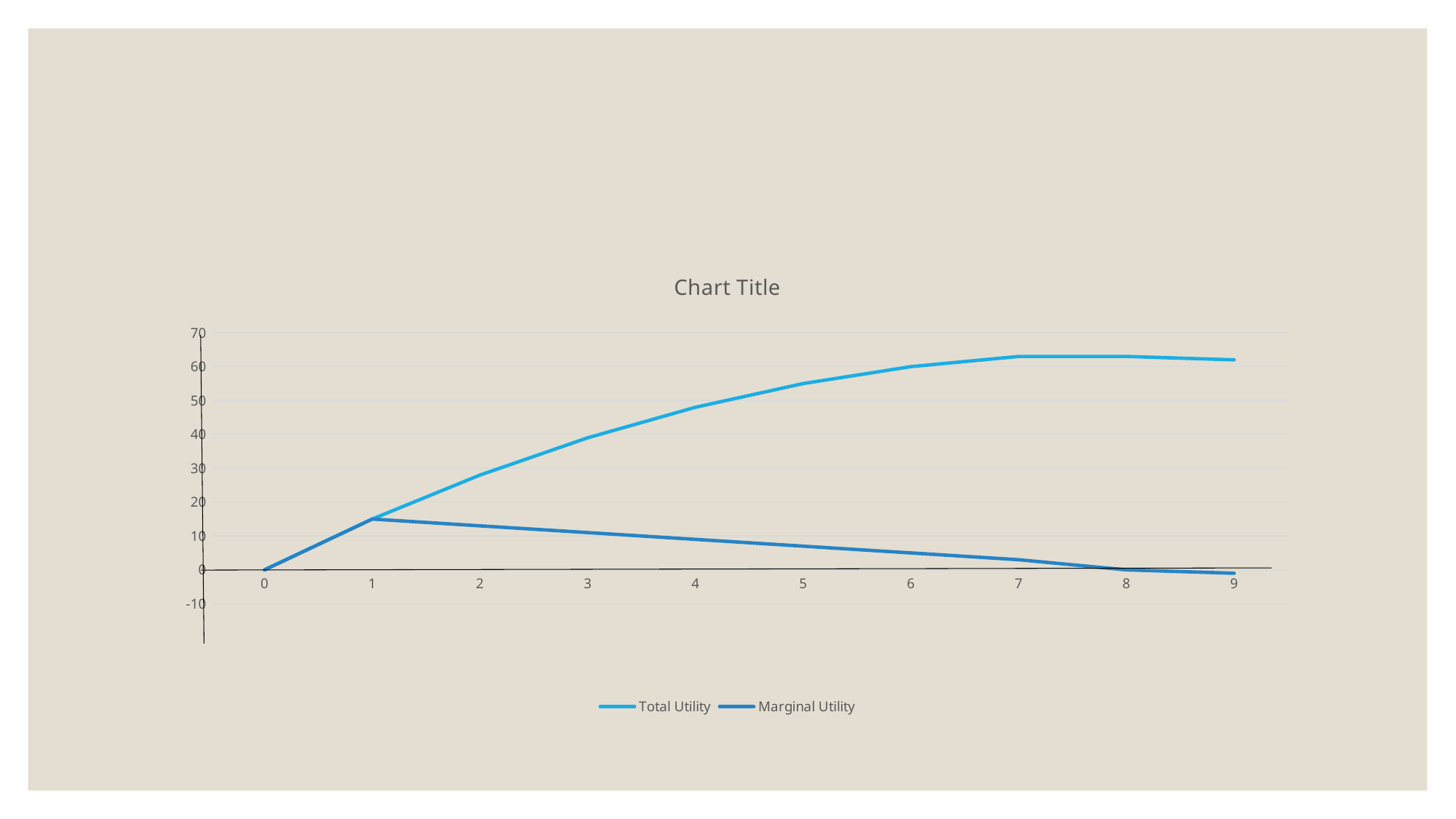
What kind of chart is shown on the slide? line chart How many points are plotted along the x axis for each series? 10 What is the value of Total Utility at x = 0? 0 Is the value of Total Utility at x = 2 greater or less than 30? less Is the value of Marginal Utility at x = 5 greater or less than 10? less What is the title of the chart? Chart Title At which x value does Marginal Utility reach its lowest point? 9 Does Marginal Utility rise or fall between x = 1 and x = 9? fall At x = 4, which series has the larger value, Total Utility or Marginal Utility? Total Utility How many series does the legend list? 2 Is the value of Total Utility at x = 5 greater or less than 50? greater